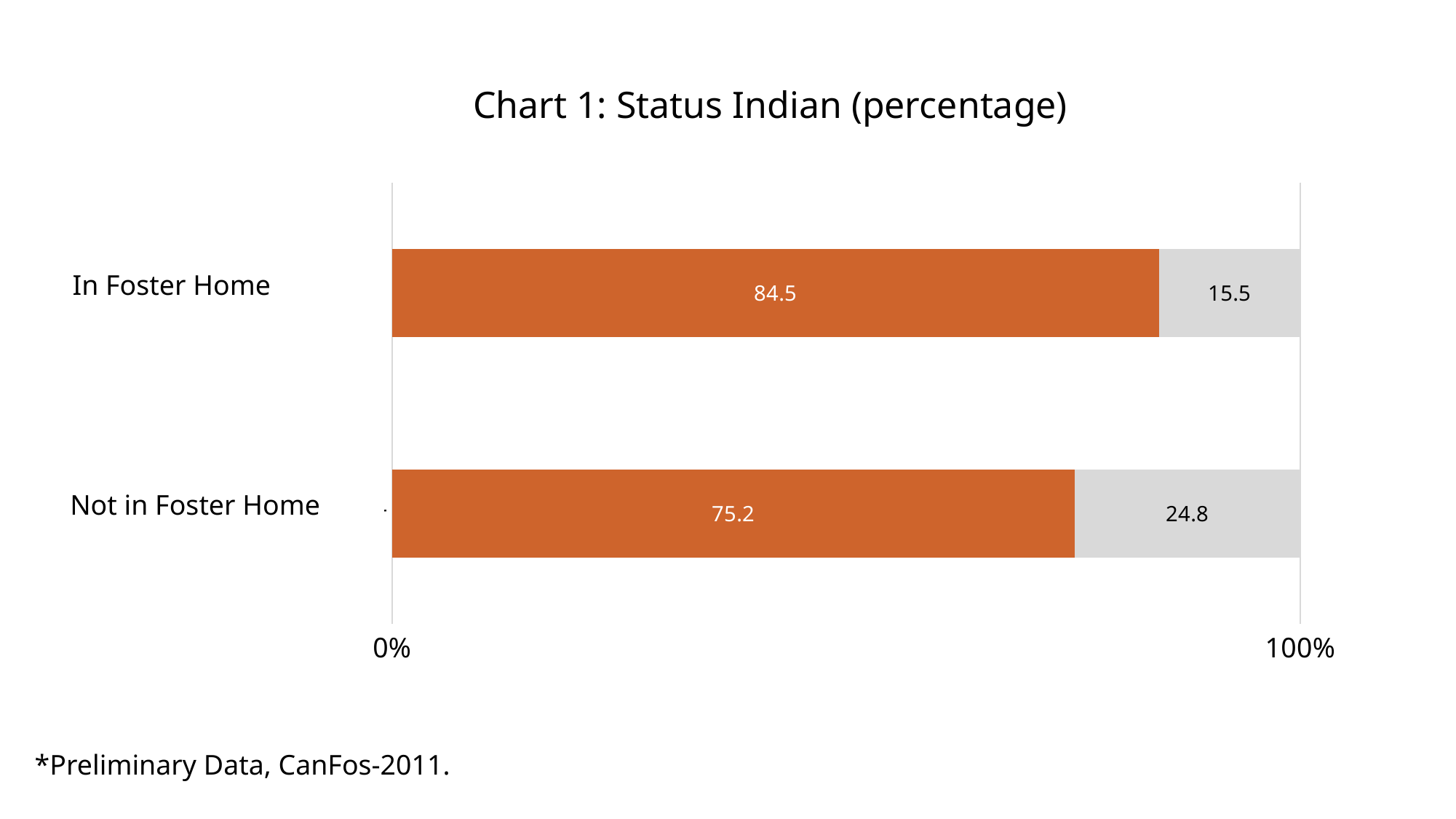
Which category has the smaller grey segment? In Foster Home What is the value of the grey segment for In Foster Home? 15.5 What is the value of the grey segment for Not in Foster Home? 24.8 What is the value of the orange segment for Not in Foster Home? 75.2 Which category has the larger orange segment? In Foster Home What is the value of the orange segment for In Foster Home? 84.5 What kind of chart is shown on the slide? Stacked bar chart What is the difference between the orange segment values for In Foster Home and Not in Foster Home? 9.3 What is the total of the stacked bar for In Foster Home? 100 How many categories are shown on the chart? 2 What is the title of the chart? Chart 1: Status Indian (percentage) Is the grey segment larger for In Foster Home or for Not in Foster Home? Not in Foster Home